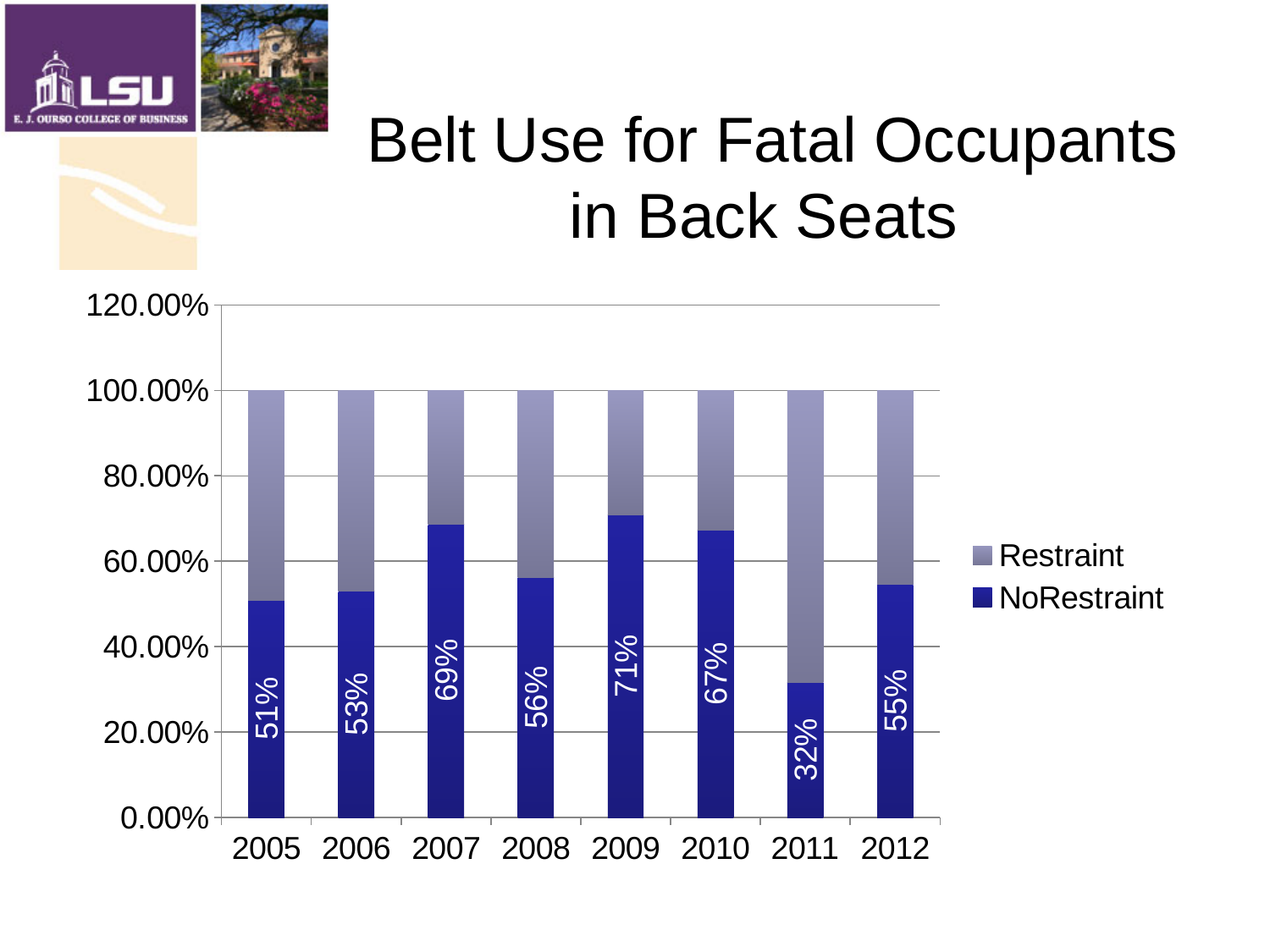
Which year has the lowest NoRestraint value? 2011 How many years are shown on the x axis? 8 Which year has a larger NoRestraint value, 2008 or 2010? 2010 Which year has the highest NoRestraint value? 2009 What is the title of the chart? Belt Use for Fatal Occupants in Back Seats What is the NoRestraint value for 2007? 69% What kind of chart is shown on the slide? Stacked bar chart How many series does the legend list? 2 What is the NoRestraint value for 2009? 71% What is the difference between the NoRestraint values for 2009 and 2011? 39% Is the Restraint value for 2011 greater or less than 60.00%? greater What is the NoRestraint value for 2011? 32%